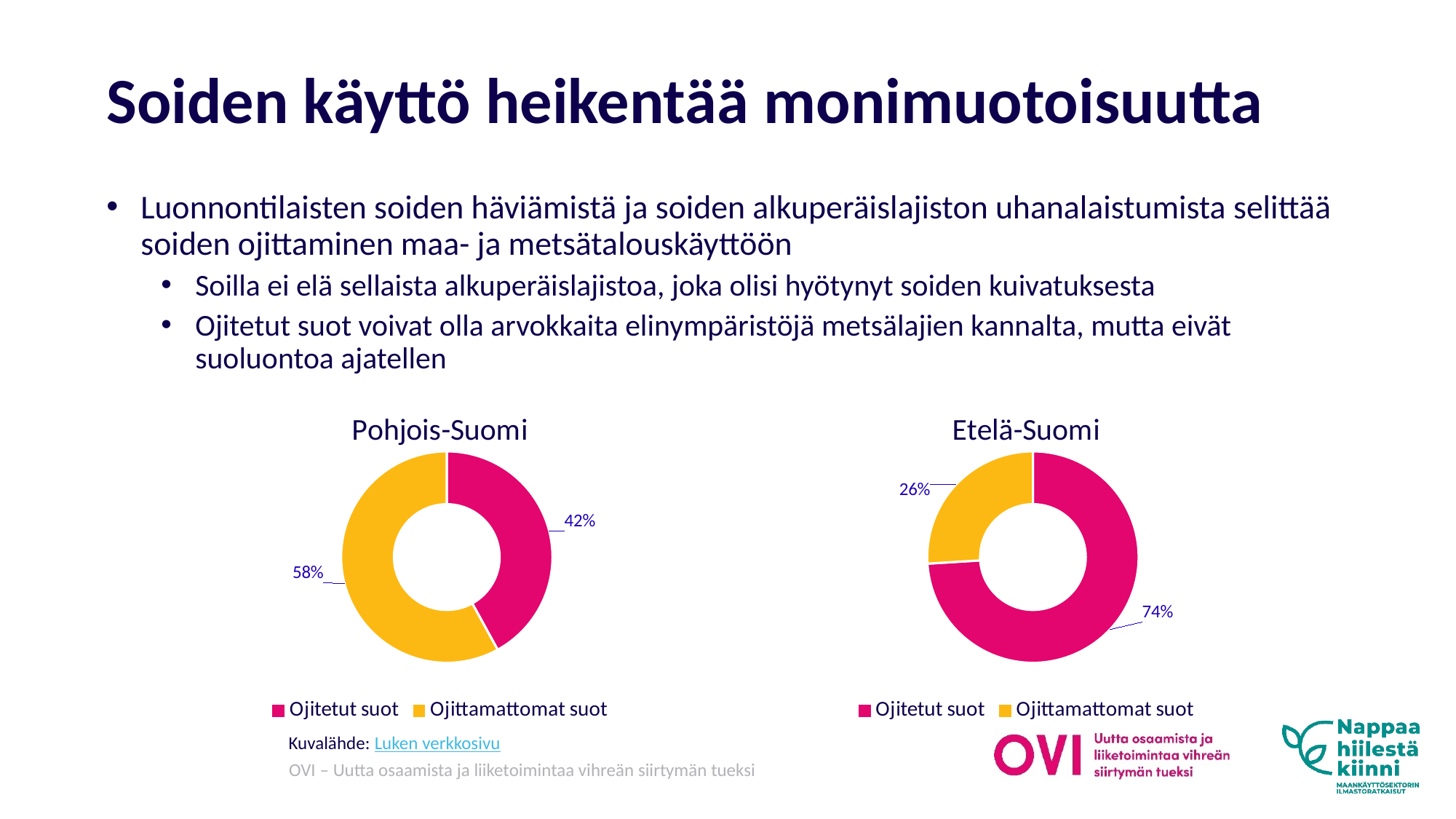
In the Pohjois-Suomi chart, which category has the larger share? Ojittamattomat suot What kind of chart is the Pohjois-Suomi chart? Doughnut chart Is the share of Ojitetut suot larger in the Pohjois-Suomi chart or the Etelä-Suomi chart? Etelä-Suomi How many categories does the Etelä-Suomi chart show? 2 In the Pohjois-Suomi chart, what share is Ojittamattomat suot? 58% In the Pohjois-Suomi chart, what colour represents Ojitetut suot? Magenta (pink) In the Etelä-Suomi chart, what share is Ojittamattomat suot? 26% In the Etelä-Suomi chart, what is the difference in percentage points between Ojitetut suot and Ojittamattomat suot? 48 In the Etelä-Suomi chart, what share is Ojitetut suot? 74% In the Pohjois-Suomi chart, what share is Ojitetut suot? 42% In the Etelä-Suomi chart, which category has the smaller share? Ojittamattomat suot What is the title of the chart on the right side of the slide? Etelä-Suomi